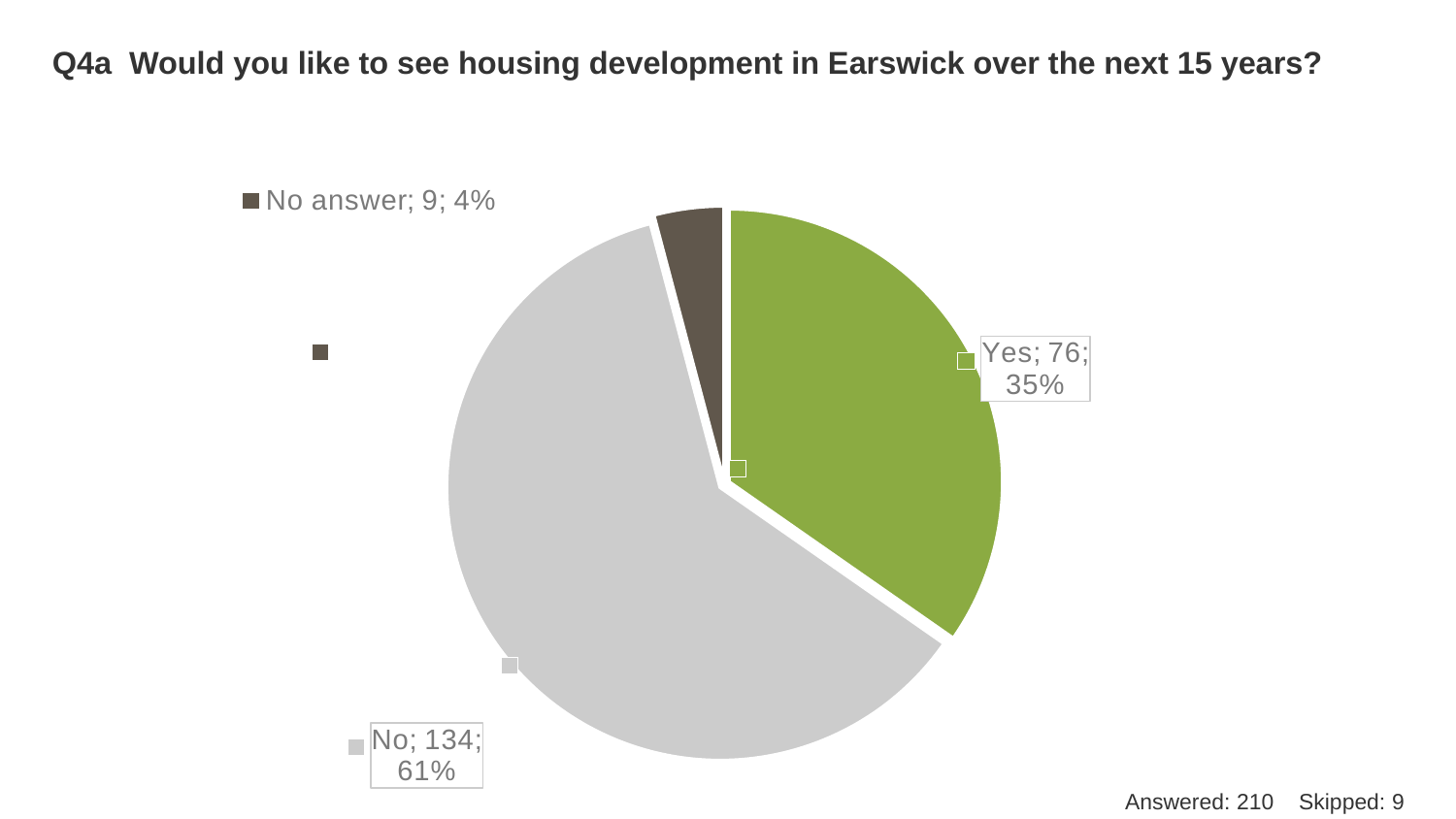
How many slices does the pie chart have? 3 Which response category has the largest slice? No How many respondents answered "Yes"? 76 What percentage of the pie does the "Yes" slice represent? 35% What kind of chart is shown on the slide? pie chart How many respondents gave "No answer"? 9 Which response category has the smallest slice? No answer What percentage of the pie does the "No answer" slice represent? 4% Which is larger, the count for "Yes" or the count for "No answer"? Yes What percentage of the pie does the "No" slice represent? 61% How many more respondents answered "No" than "Yes"? 58 How many respondents answered "No"? 134